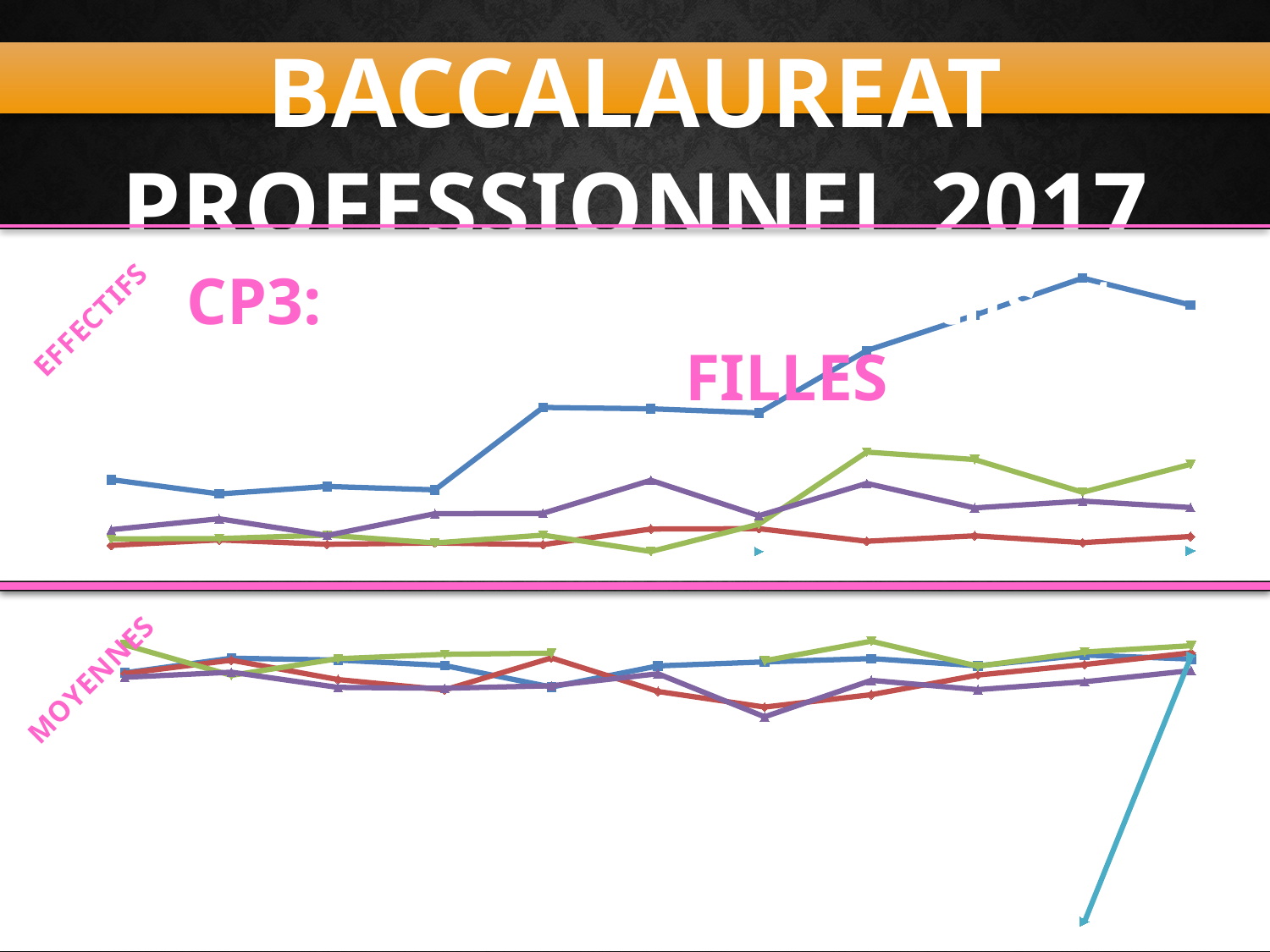
In the upper chart labelled EFFECTIFS, is the last point of the blue line higher or lower than the last point of the red line? higher In the upper chart labelled EFFECTIFS, how many data points does the blue line have? 11 What kind of chart is the lower chart labelled MOYENNES? line chart What label is written in pink next to the lower chart? MOYENNES What label is written in pink next to the upper chart? EFFECTIFS What kind of chart is the upper chart labelled EFFECTIFS? line chart In the lower chart labelled MOYENNES, how many data points does the red line have? 11 In the upper chart labelled EFFECTIFS, which coloured line reaches the highest point? blue In the upper chart labelled EFFECTIFS, does the blue line overall rise or fall from left to right? rise